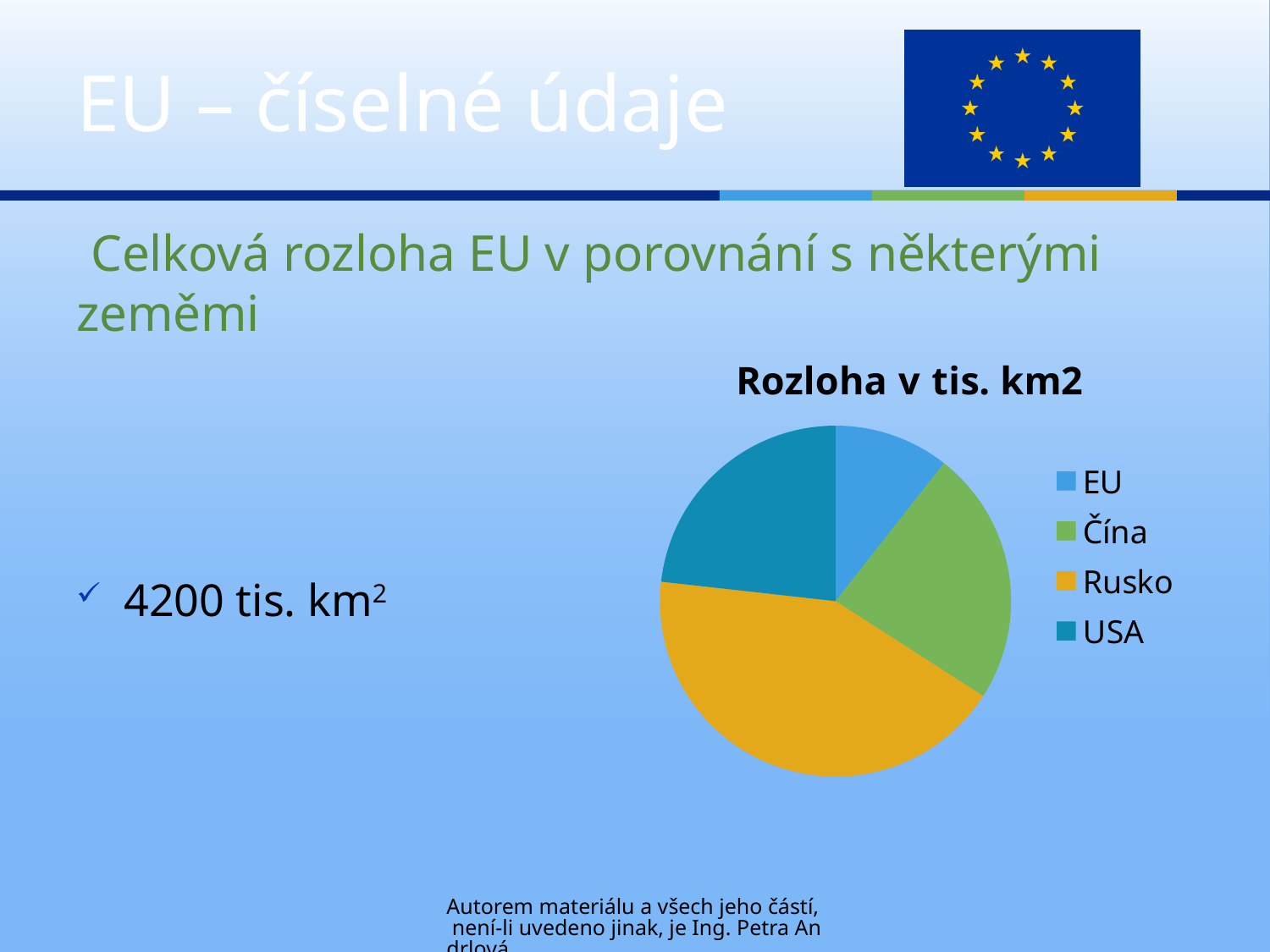
What is the title of the chart? Rozloha v tis. km2 Does the Rusko slice take up more or less than half of the pie? less How many slices does the pie chart have? 4 Which category has the smallest slice of the pie? EU Which slice is larger, Rusko or Čína? Rusko Which slice is larger, Čína or EU? Čína Which category is shown in yellow/orange in the pie chart? Rusko How many entries does the chart legend list? 4 Which slice is larger, USA or EU? USA What kind of chart is shown on the slide? pie chart Which category has the largest slice of the pie? Rusko